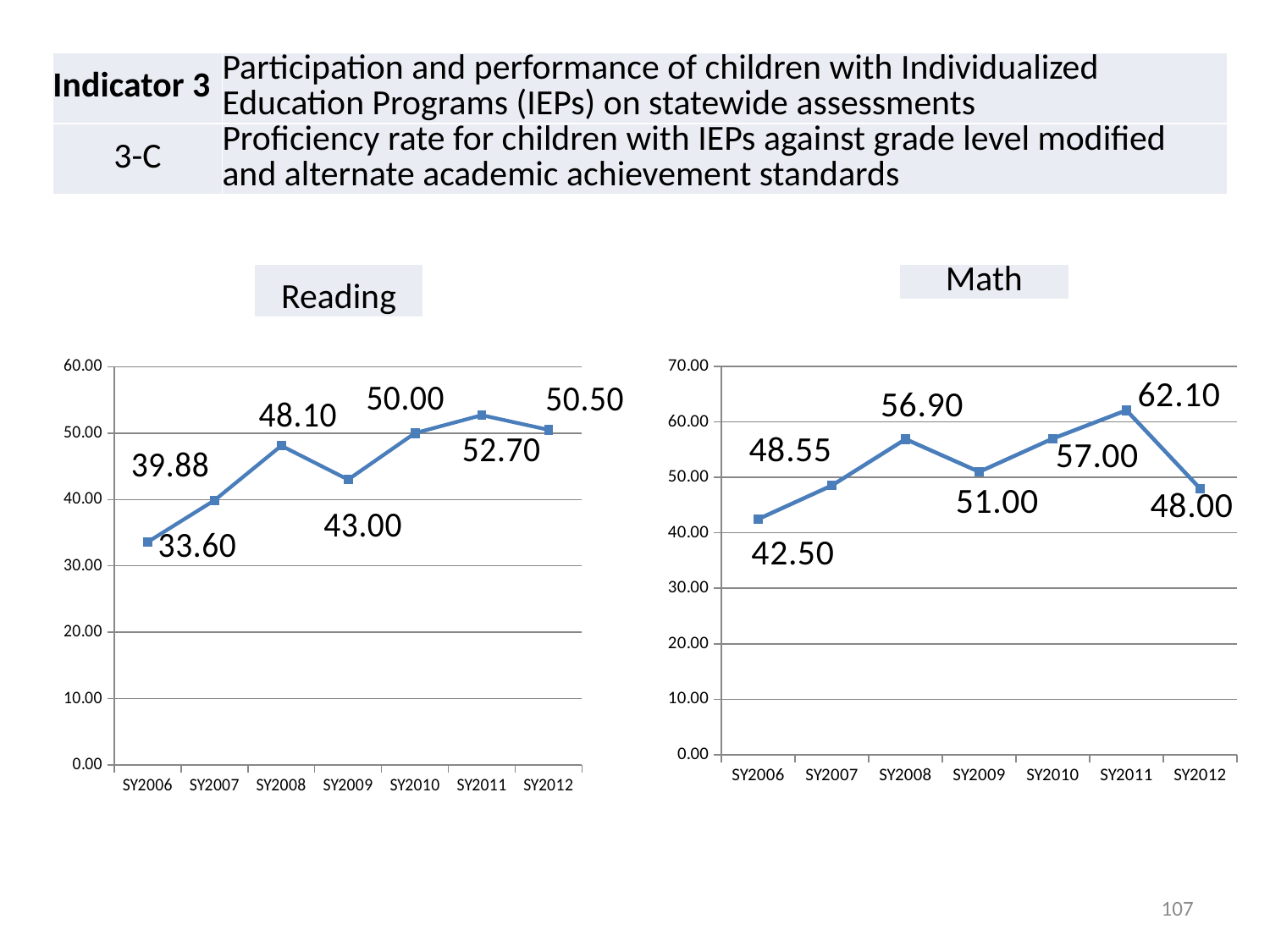
In the Reading chart, what is the value for SY2006? 33.60 In the Math chart, which school year has the lowest value? SY2006 In the Math chart, what is the difference between the values for SY2011 and SY2012? 14.10 In the Math chart, what is the value for SY2011? 62.10 In the Math chart, which is larger, the value for SY2008 or the value for SY2009? SY2008 In the Reading chart, what is the difference between the values for SY2011 and SY2006? 19.10 What kind of chart is the Reading chart? line chart In the Math chart, does the value rise or fall from SY2011 to SY2012? fall How many school years are plotted in the Math chart? 7 In the Reading chart, is the value for SY2009 greater or less than 40.00? greater In the Reading chart, which school year has the highest value? SY2011 In the Reading chart, what is the value for SY2010? 50.00